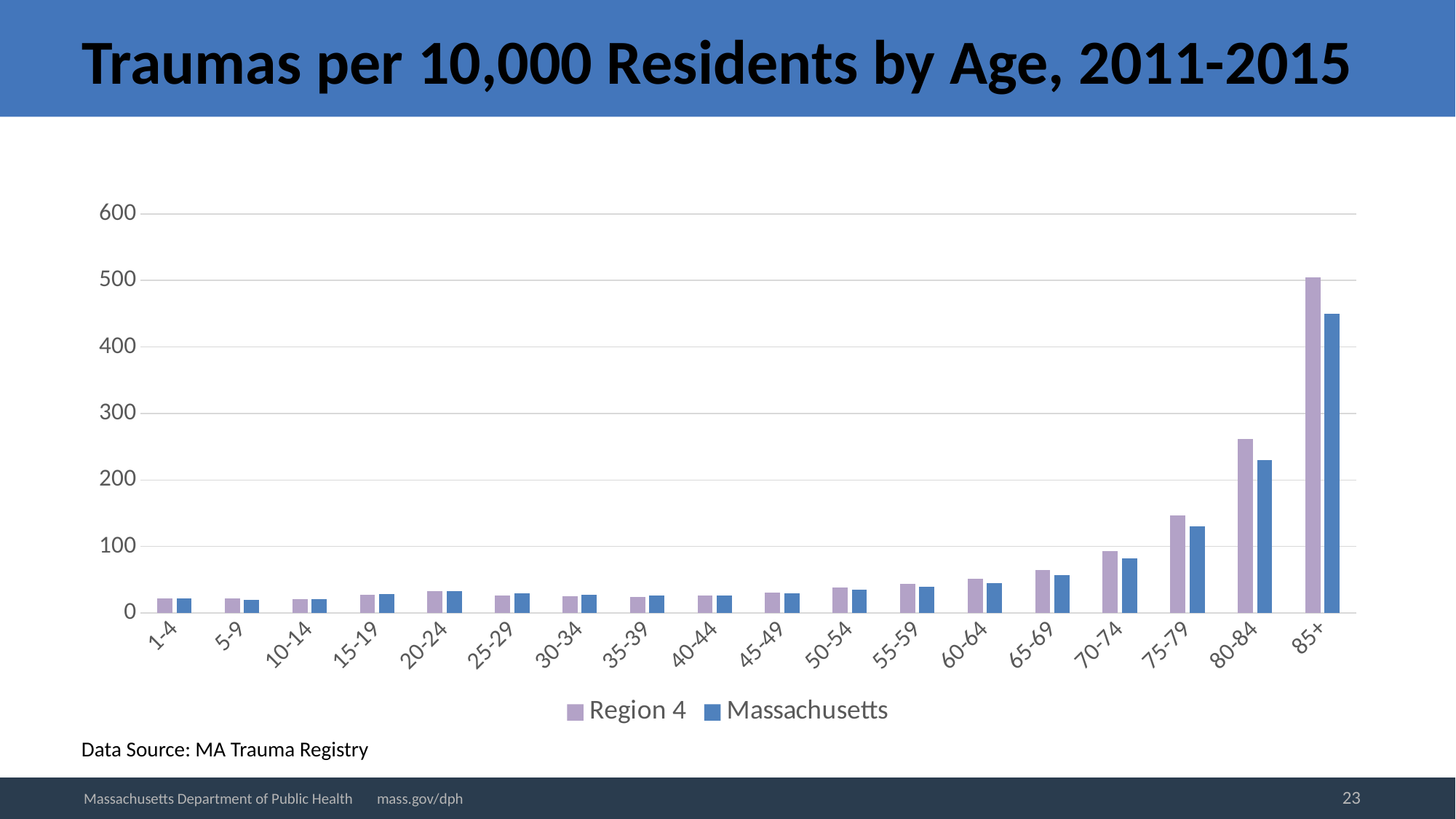
For the 85+ age group, which is larger: Region 4 or Massachusetts? Region 4 How many series does the legend list? 2 What is the data source named below the chart? MA Trauma Registry Is the Region 4 value for the 80-84 age group greater or less than 300? less Is the Region 4 value for the 85+ age group greater or less than 400? greater Is the Massachusetts value for the 85+ age group greater or less than 500? less Which age group has the highest value for Region 4? 85+ What kind of chart is shown on the slide? bar chart Which age group has the highest value for Massachusetts? 85+ How many age groups are shown on the x axis? 18 Do the values generally rise or fall as age increases along the x axis? rise